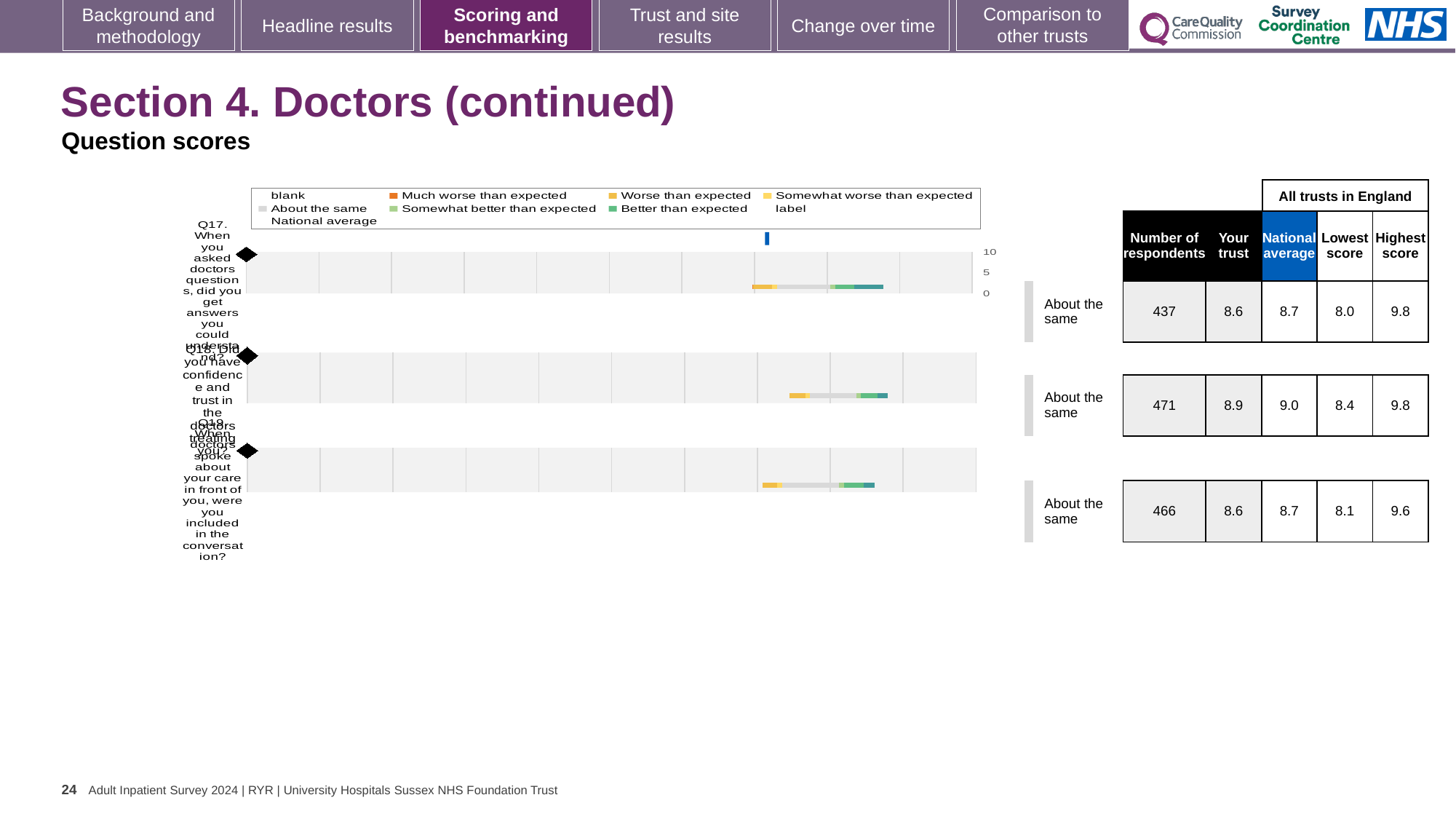
Is the 'Your trust' score for Q18 higher or lower than the national average for Q18? lower What kind of chart is used to show the question scores on this slide? bar chart Which question has the highest 'Your trust' score? Q18 What is the lowest score among all trusts in England for Q19? 8.1 What benchmark category is shown for all three questions on this slide? About the same How many questions are plotted in the chart? 3 How many respondents answered Q19 (included in the conversation)? 466 What is the difference between the highest score and the lowest score for Q17? 1.8 What is the national average score for Q17 (answers you could understand)? 8.7 What is the 'Your trust' score for Q18 (confidence and trust in the doctors)? 8.9 How many entries does the chart legend list? 9